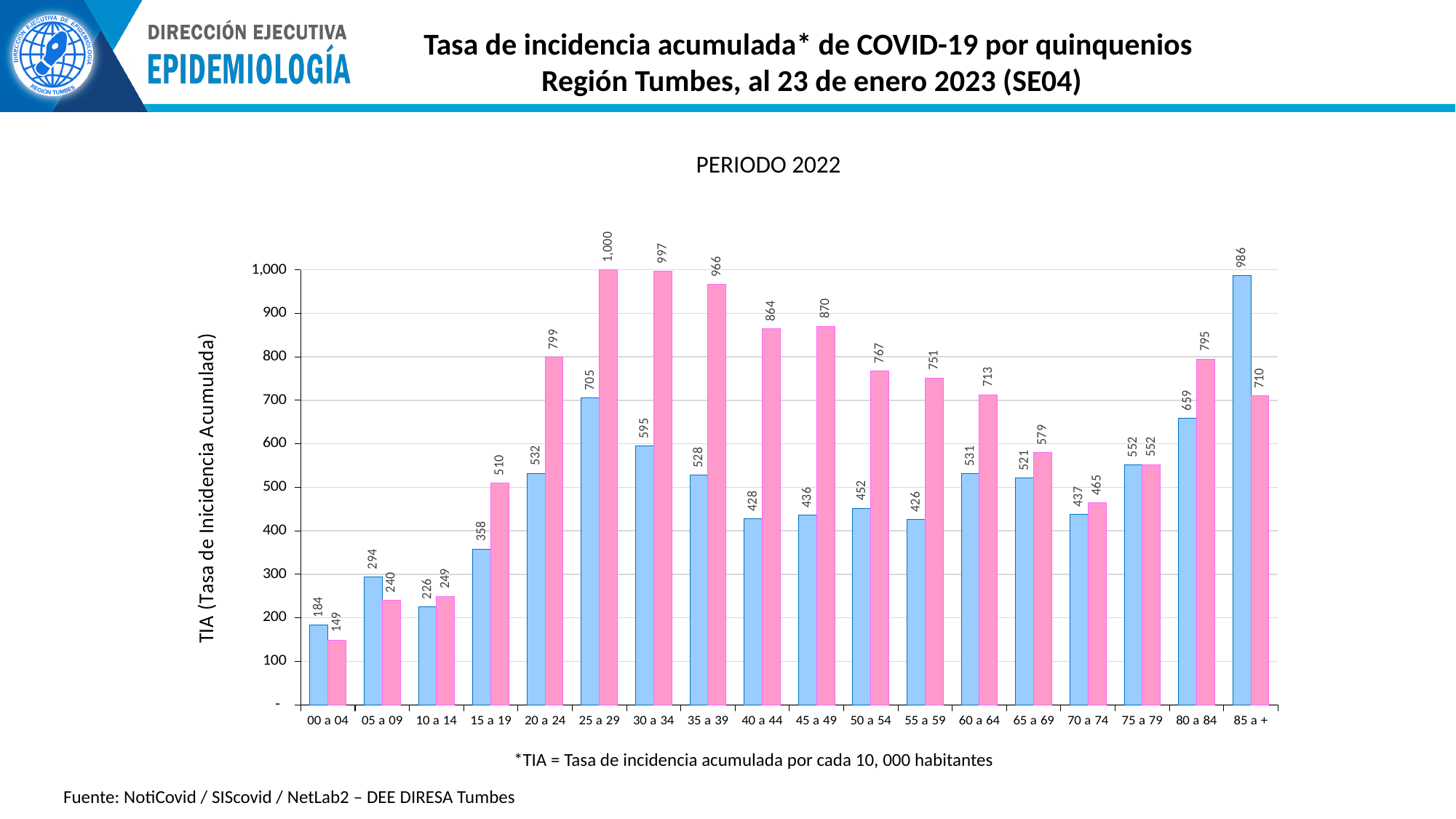
What is the value of the pink bar for the 85 a + age group? 710 Which age group has the highest pink bar? 25 a 29 What is the difference between the pink and blue bars for the 20 a 24 age group? 267 How many age groups are shown on the x axis? 18 Which age group has the highest blue bar? 85 a + Which age group has the lowest pink bar? 00 a 04 For the 85 a + age group, which bar is larger, the blue or the pink? blue Is the value of the pink bar for the 35 a 39 age group greater or less than 900? greater What is the value of the pink bar for the 40 a 44 age group? 864 What is the title shown above the chart? PERIODO 2022 What kind of chart is shown on the slide? bar chart What is the value of the blue bar for the 25 a 29 age group? 705